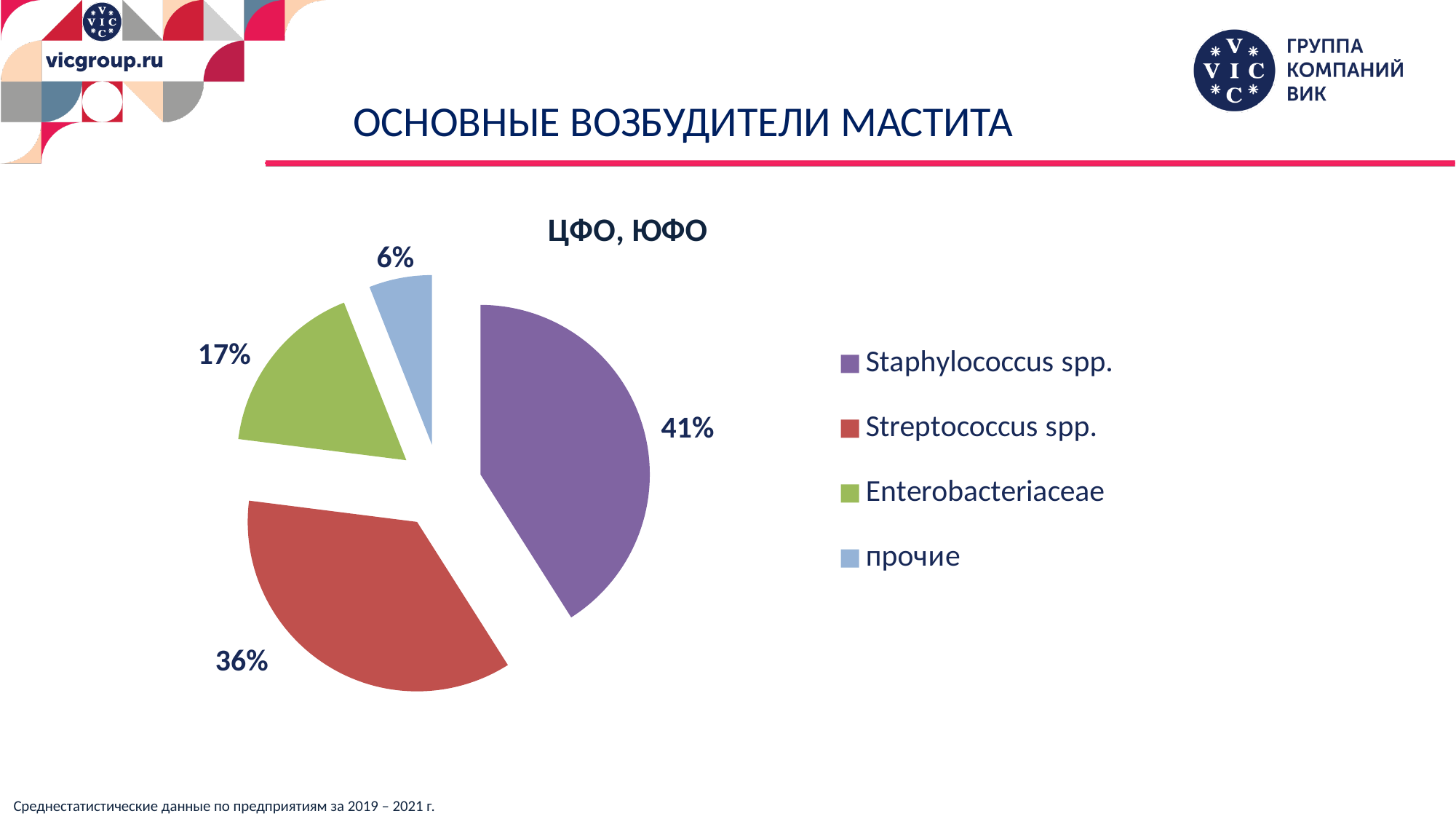
What is the difference between the Staphylococcus spp. and Streptococcus spp. shares? 5% How many slices does the pie chart have? 4 What is the value shown for Streptococcus spp.? 36% Which category has the largest slice of the pie? Staphylococcus spp. What is the value shown for Enterobacteriaceae? 17% Which is larger, the share for Enterobacteriaceae or the share for Streptococcus spp.? Streptococcus spp. Which category has the smallest slice of the pie? прочие What is the difference between the Enterobacteriaceae and 'прочие' shares? 11% What kind of chart is shown on the slide? Pie chart What share of the pie does Staphylococcus spp. account for? 41% What is the value shown for the 'прочие' slice? 6% What is the title of the chart? ЦФО, ЮФО